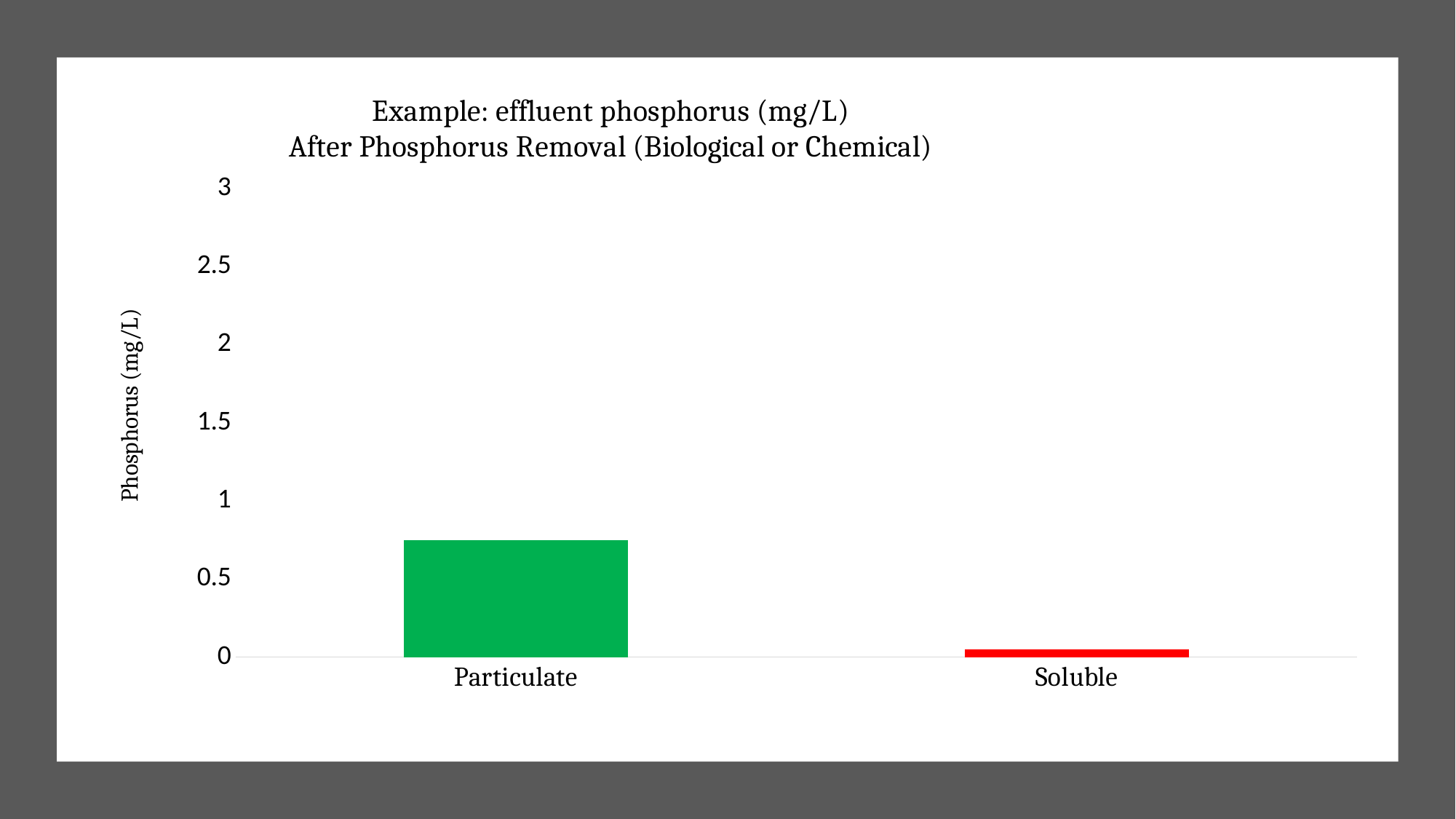
What is the label of the y axis? Phosphorus (mg/L) Is the value for Particulate greater or less than 0.5? greater How many categories are shown on the x axis? 2 What colour is the bar for Soluble? red Is the value for Soluble greater or less than 0.5? less Which is larger, the value for Particulate or the value for Soluble? Particulate Which category has the lowest phosphorus value? Soluble Is the value for Particulate greater or less than 1? less What kind of chart is shown on the slide? bar chart Which category has the highest phosphorus value? Particulate What is the highest value shown on the y axis? 3